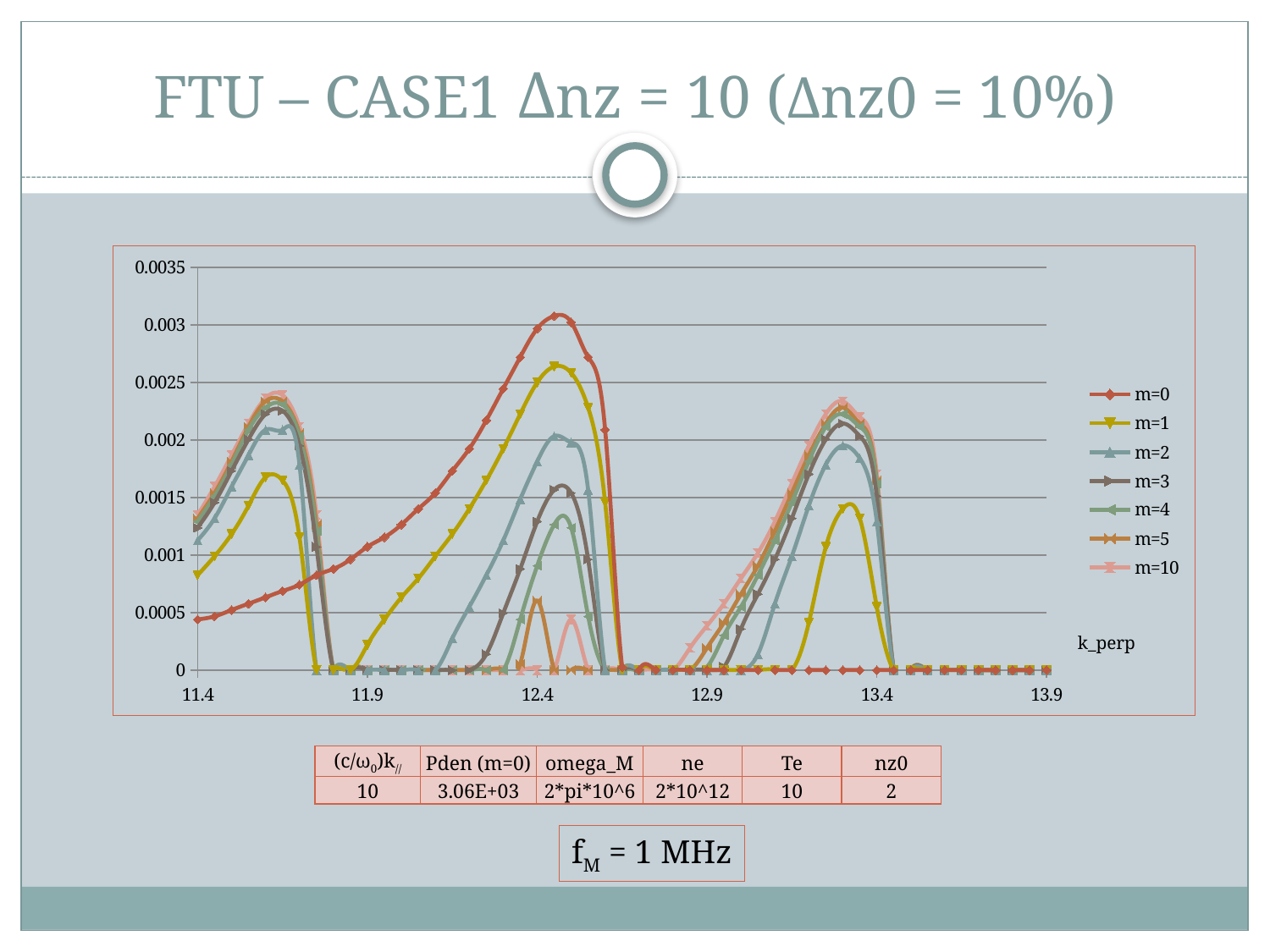
In the first hump around k_perp = 11.6, which series has the lowest peak? m=1 What are the series names listed in the legend? m=0, m=1, m=2, m=3, m=4, m=5, m=10 What kind of chart is shown on the slide? line chart Is the value of the m=0 series at k_perp = 11.4 greater or less than 0.001? less Is the peak value of the m=1 series in the middle hump (near k_perp = 12.45) greater or less than 0.002? greater How many series does the legend list? 7 Is the peak value of the m=0 series (near k_perp = 12.45) greater or less than 0.0025? greater Which series reaches the highest peak value anywhere on the chart? m=0 In the middle hump around k_perp = 12.4, which series reaches a higher peak, m=0 or m=5? m=0 What label is shown for the x axis of the chart? k_perp